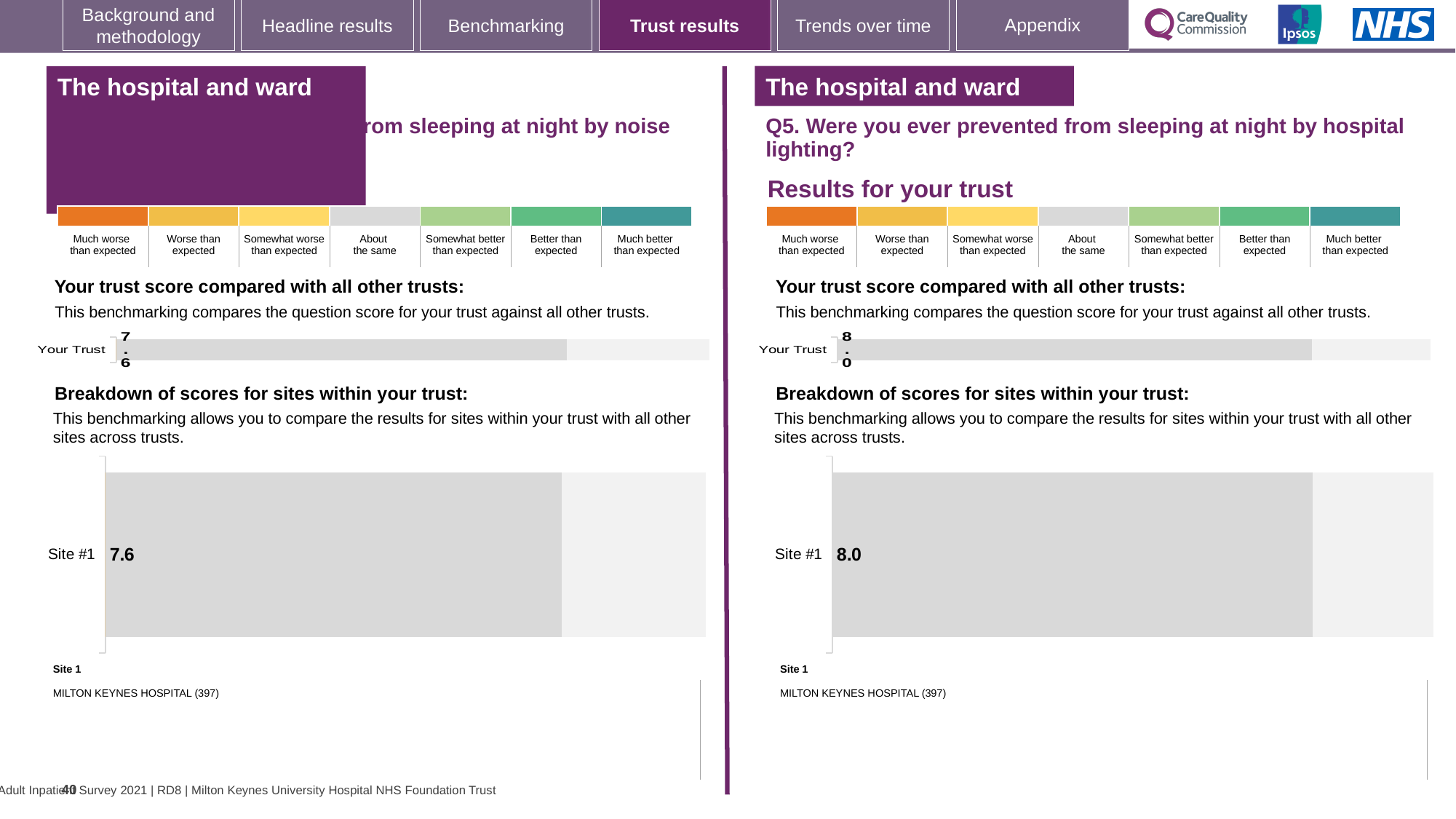
On the right-hand side of the slide (Q5, hospital lighting), what is the 'Your Trust' score shown in the 'Your trust score compared with all other trusts' chart? 8.0 What type of chart is used for the 'Breakdown of scores for sites within your trust' on the right-hand side of the slide? Bar chart In the left-hand 'Breakdown of scores for sites within your trust' chart, what is the score for Site #1? 7.6 How many sites are plotted in the right-hand 'Breakdown of scores for sites within your trust' chart (Q5, hospital lighting)? 1 How many sites are plotted in the left-hand 'Breakdown of scores for sites within your trust' chart? 1 Which is larger: the Site #1 score in the left-hand breakdown chart or the Site #1 score in the right-hand breakdown chart (Q5, hospital lighting)? The right-hand chart (Q5, hospital lighting) In the right-hand 'Breakdown of scores for sites within your trust' chart (Q5, hospital lighting), what is the score for Site #1? 8.0 What is the difference between the Site #1 score in the right-hand breakdown chart (Q5, hospital lighting) and the Site #1 score in the left-hand breakdown chart? 0.4 What is the category label of the single bar in the left-hand 'Breakdown of scores for sites within your trust' chart? Site #1 What type of chart is used to show the 'Your Trust' score on the left-hand side of the slide? Bar chart On the left-hand side of the slide, what is the 'Your Trust' score shown in the 'Your trust score compared with all other trusts' chart? 7.6 Which hospital is listed as Site 1 beneath the right-hand breakdown chart (Q5, hospital lighting)? MILTON KEYNES HOSPITAL (397)